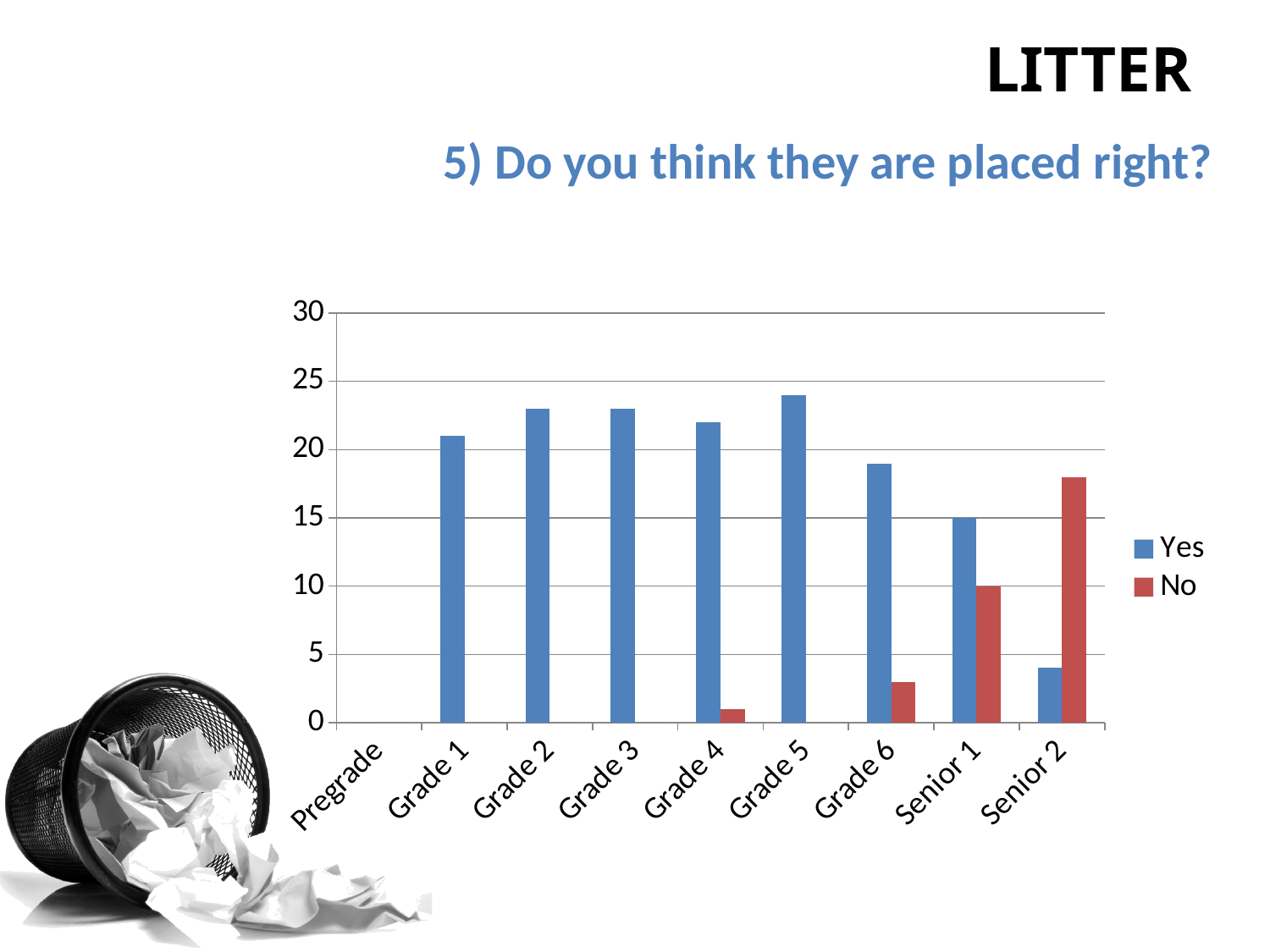
How many categories are shown on the x axis? 9 Do the 'Yes' values rise or fall from Grade 5 to Senior 2? fall Is the 'Yes' value for Grade 5 greater or less than 20? greater How many series does the legend list? 2 Which category has the highest 'No' value? Senior 2 Is the 'No' value for Grade 6 greater or less than 5? less Which category has the lowest non-zero 'Yes' value? Senior 2 For Grade 6, which is larger, the 'Yes' value or the 'No' value? Yes For Senior 2, which is larger, the 'Yes' value or the 'No' value? No What colour are the 'No' bars in the chart? red Is the 'No' value for Senior 2 greater or less than 15? greater What kind of chart is shown on the slide? bar chart